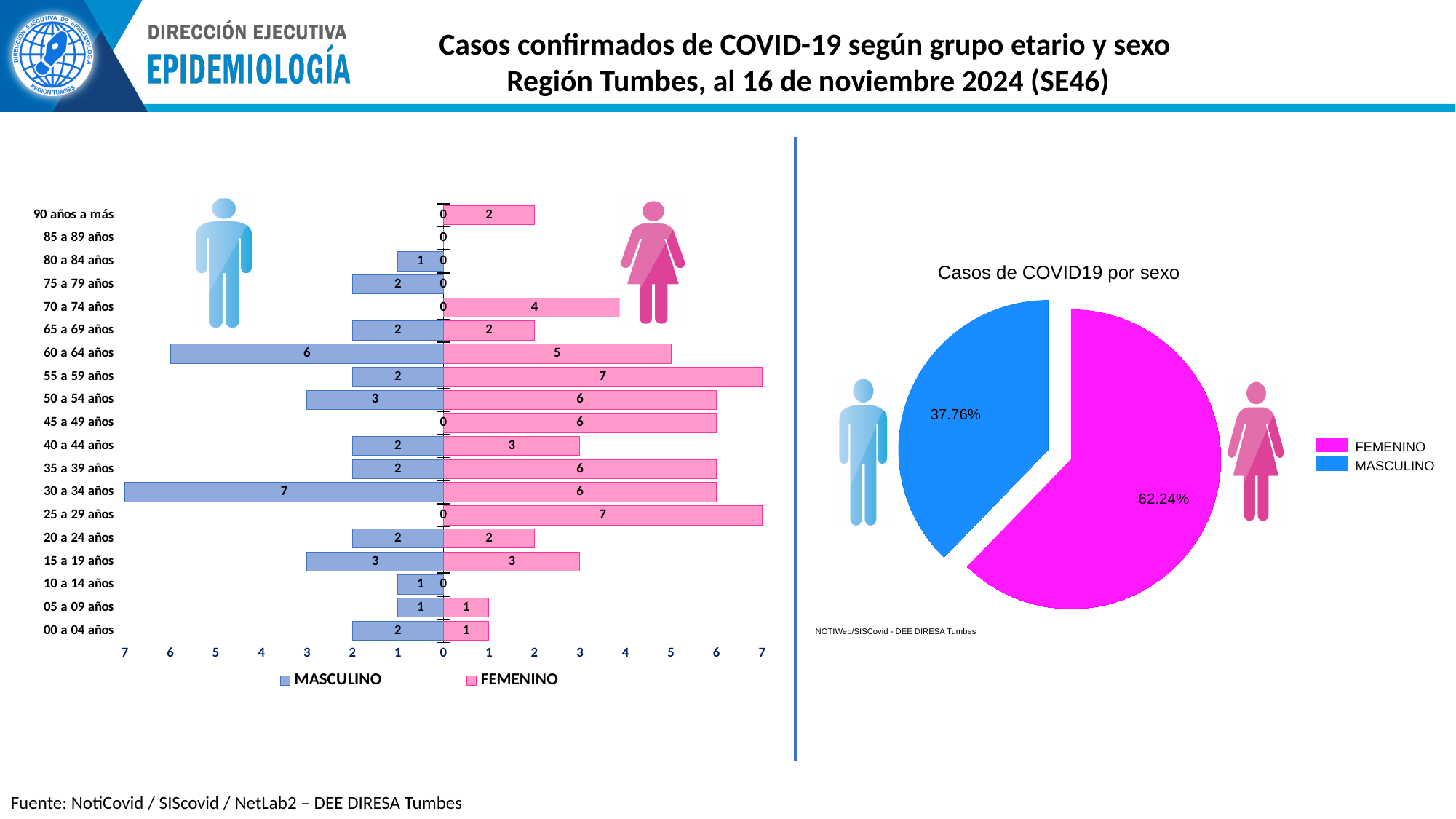
In the age-and-sex bar chart on the left, how many FEMENINO cases are in the 55 a 59 años group? 7 What type of chart is the chart titled 'Casos de COVID19 por sexo'? Pie chart In the age-and-sex bar chart on the left, how many FEMENINO cases are in the 70 a 74 años group? 4 How many age groups are shown in the age-and-sex bar chart on the left? 19 How many series does the legend of the age-and-sex bar chart on the left list? 2 In the age-and-sex bar chart on the left, what is the difference between FEMENINO and MASCULINO cases in the 50 a 54 años group? 3 In the pie chart 'Casos de COVID19 por sexo', what share of cases is MASCULINO? 37.76% In the pie chart 'Casos de COVID19 por sexo', what share of cases is FEMENINO? 62.24% In the age-and-sex bar chart on the left, what is the total of MASCULINO and FEMENINO cases in the 15 a 19 años group? 6 In the age-and-sex bar chart on the left, how many MASCULINO cases are in the 30 a 34 años group? 7 In the age-and-sex bar chart on the left, which is larger in the 60 a 64 años group, MASCULINO or FEMENINO? MASCULINO In the age-and-sex bar chart on the left, which age group has the highest number of MASCULINO cases? 30 a 34 años